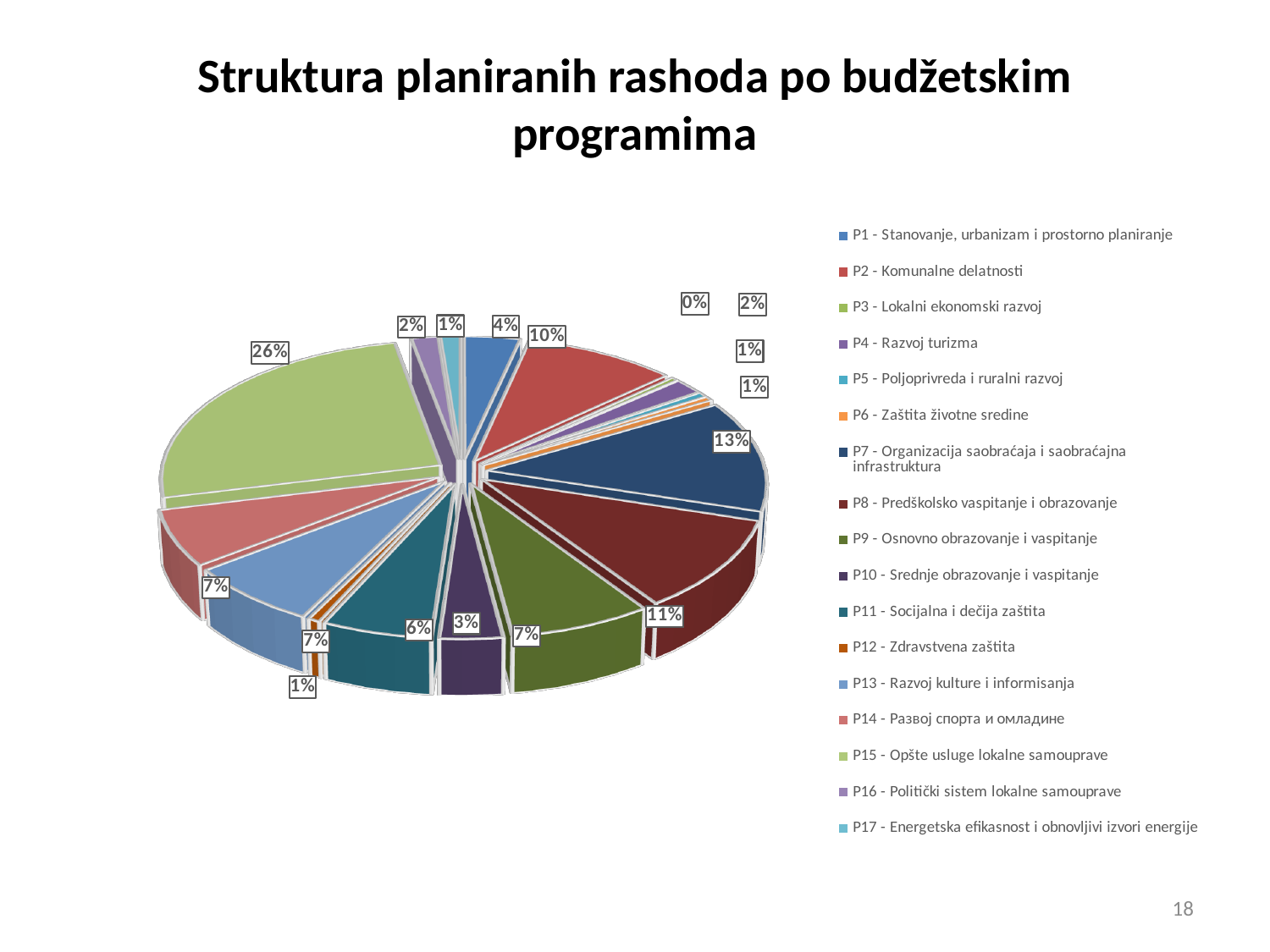
What share of planned expenditures goes to P8 - Predškolsko vaspitanje i obrazovanje? 11% What share of planned expenditures goes to P2 - Komunalne delatnosti? 10% What kind of chart is shown on the slide? pie chart What share of planned expenditures goes to P15 - Opšte usluge lokalne samouprave? 26% Which has a larger share: P7 - Organizacija saobraćaja i saobraćajna infrastruktura or P8 - Predškolsko vaspitanje i obrazovanje? P7 - Organizacija saobraćaja i saobraćajna infrastruktura What is the difference in share between P15 - Opšte usluge lokalne samouprave and P7 - Organizacija saobraćaja i saobraćajna infrastruktura? 13% What is the title of the chart? Struktura planiranih rashoda po budžetskim programima Which program has the largest share of planned expenditures? P15 - Opšte usluge lokalne samouprave Which program has the smallest share, shown as 0%? P3 - Lokalni ekonomski razvoj How many programs (slices) does the legend list? 17